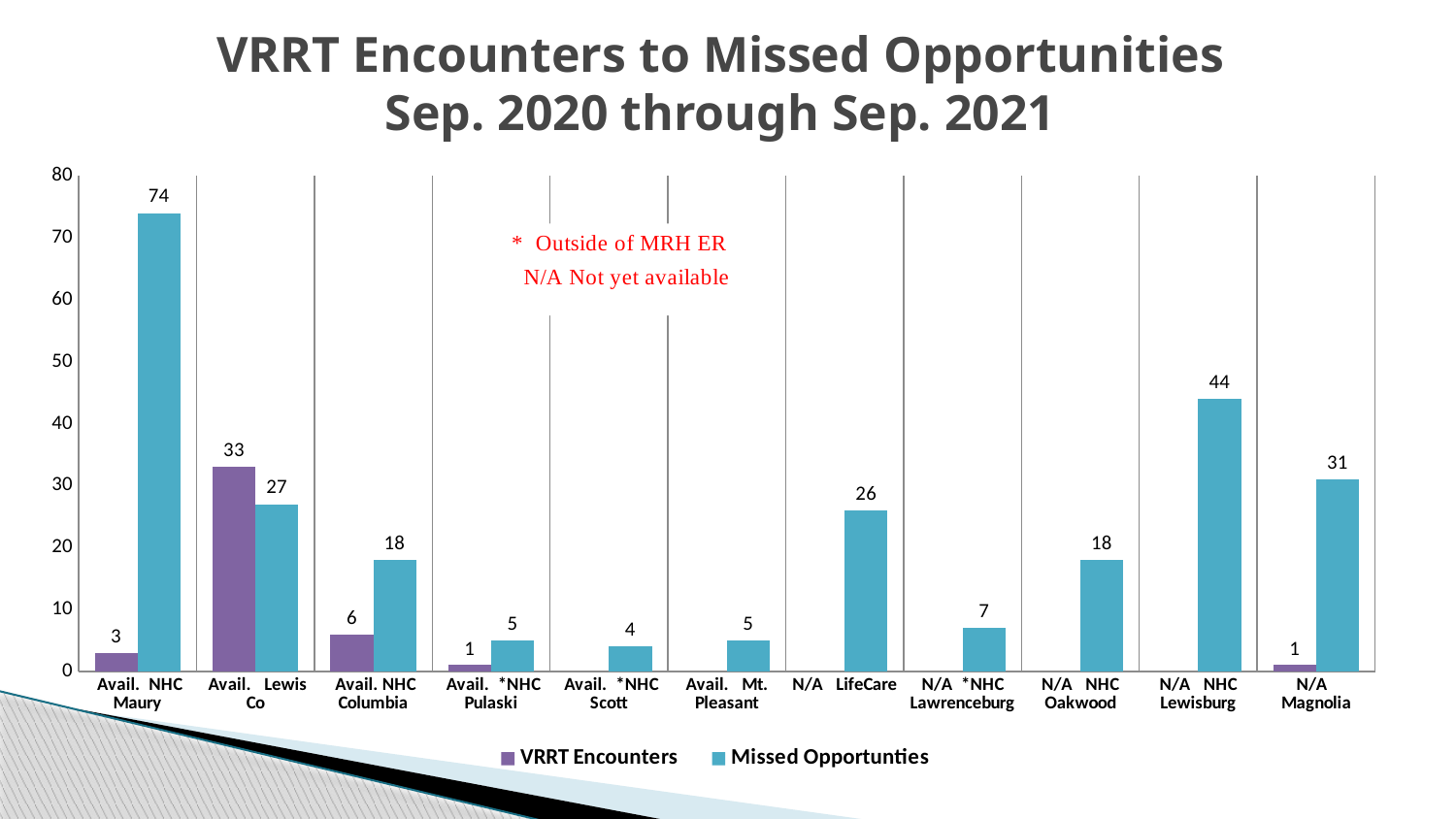
What is the Missed Opportunities value for N/A NHC Lewisburg? 44 Which category has the highest Missed Opportunities value? Avail. NHC Maury How many categories are shown on the x axis? 11 What is the difference between the Missed Opportunities values for N/A NHC Lewisburg and N/A Magnolia? 13 Is the Missed Opportunities value for N/A LifeCare greater or less than 20? greater What is the difference between Missed Opportunities and VRRT Encounters for Avail. NHC Maury? 71 For Avail. Lewis Co, which is larger: VRRT Encounters or Missed Opportunities? VRRT Encounters Which category has the highest VRRT Encounters value? Avail. Lewis Co What is the Missed Opportunities value for Avail. NHC Maury? 74 What is the VRRT Encounters value for Avail. Lewis Co? 33 How many series does the legend list? 2 What kind of chart is shown on the slide? Bar chart